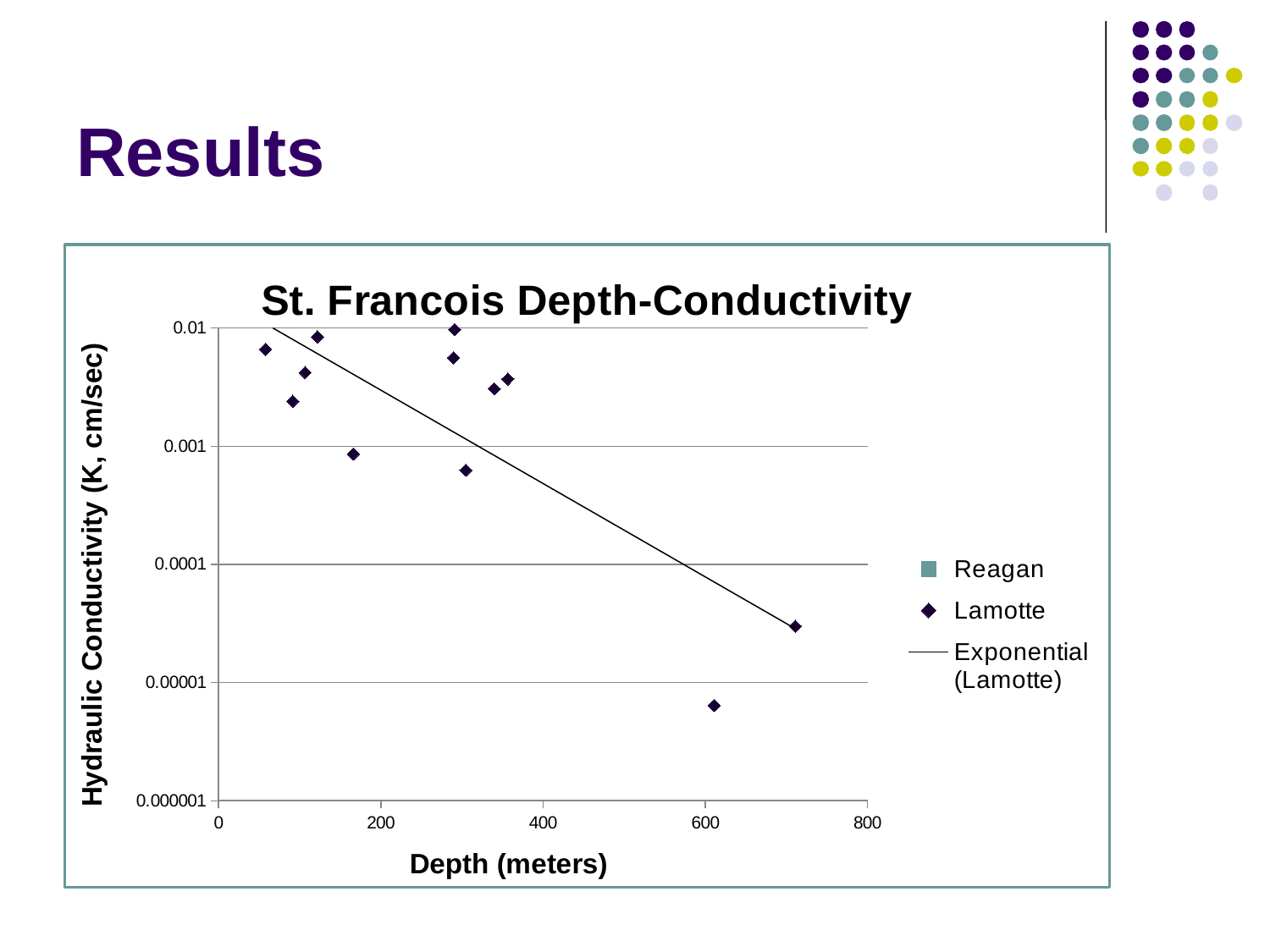
What kind of chart is shown on the slide? scatter chart Does the Exponential (Lamotte) trend line rise or fall as depth increases? fall Is the hydraulic conductivity of the Lamotte point at a depth of about 55 meters greater or less than 0.001? greater Is the hydraulic conductivity of the Lamotte point at a depth of about 710 meters greater or less than 0.0001? less What is the label of the x axis? Depth (meters) Which has the higher hydraulic conductivity: the Lamotte point at about 610 meters depth or the one at about 710 meters depth? the one at about 710 meters Is the hydraulic conductivity of the Lamotte point at a depth of about 610 meters greater or less than 0.00001? less What is the title of the chart? St. Francois Depth-Conductivity How many entries does the chart's legend list? 3